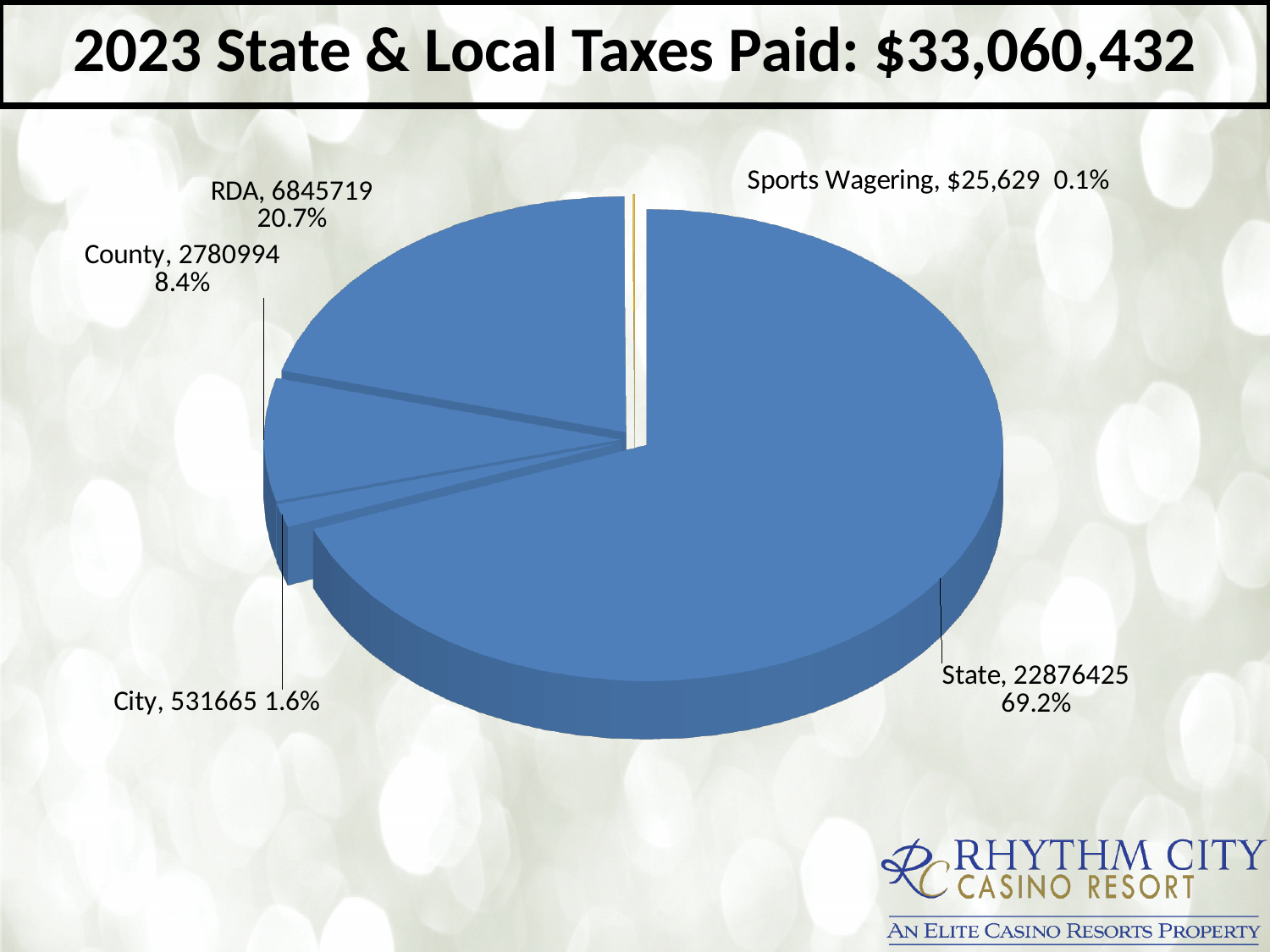
Which category has the largest slice of the pie? State What percentage share of the pie does County represent? 8.4% What is the title of the chart on the slide? 2023 State & Local Taxes Paid: $33,060,432 What is the difference between the State value and the RDA value? 16030706 What percentage share of the pie does State represent? 69.2% What is the value shown for State? 22876425 What is the value shown for Sports Wagering? $25,629 What type of chart is shown on the slide? Pie chart Which is larger, the value for County or the value for City? County What is the value shown for RDA? 6845719 Which category has the smallest slice of the pie? Sports Wagering How many slices does the pie chart have? 5